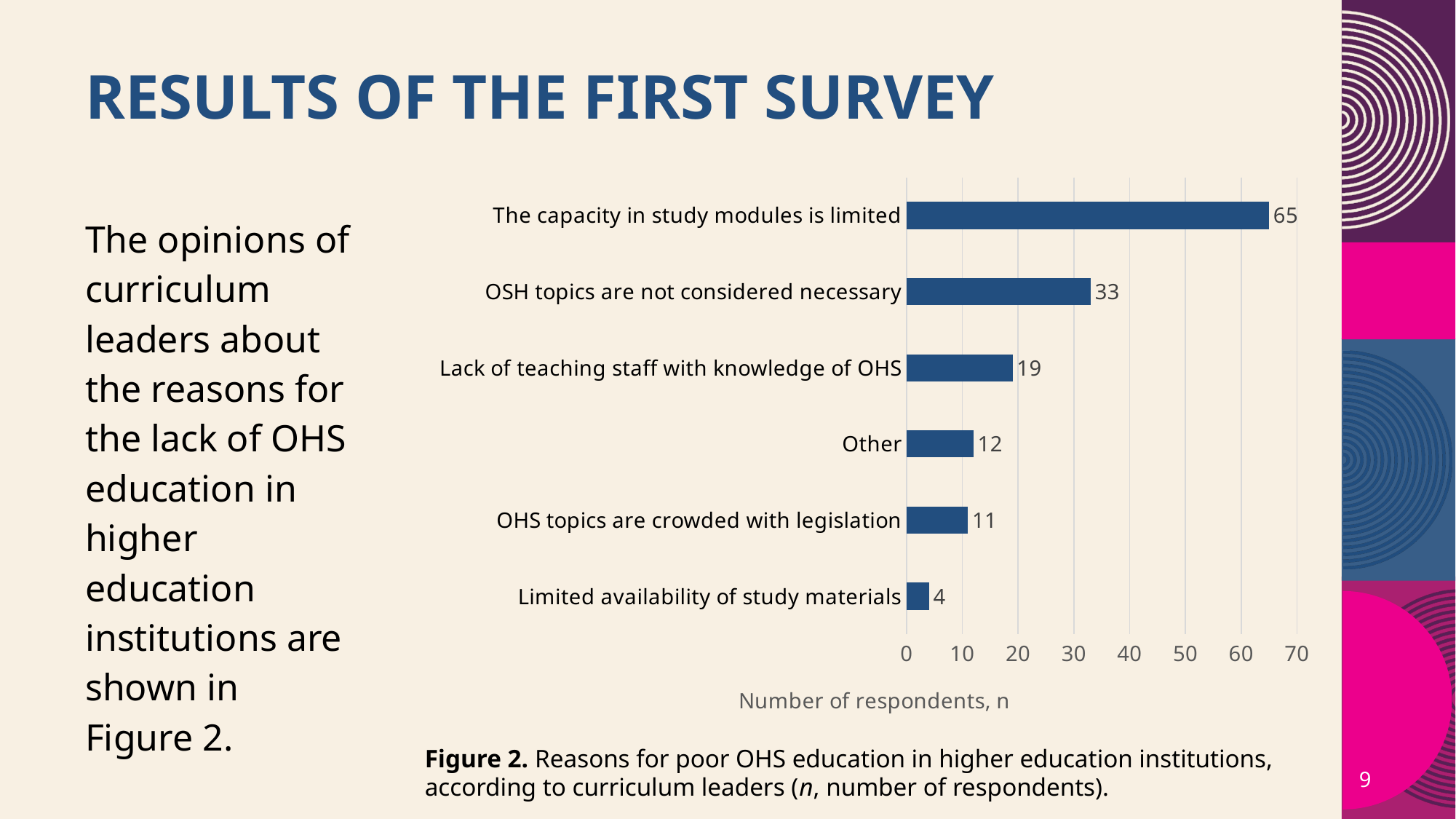
Which has more respondents: 'Other' or 'OHS topics are crowded with legislation'? Other Which reason has the lowest number of respondents? Limited availability of study materials What is the value for 'OSH topics are not considered necessary'? 33 Is the value for 'Lack of teaching staff with knowledge of OHS' greater or less than 20? less Which reason has the highest number of respondents? The capacity in study modules is limited What is the difference between the values for 'The capacity in study modules is limited' and 'OSH topics are not considered necessary'? 32 How many respondents cited 'The capacity in study modules is limited' as a reason? 65 What is the label of the horizontal axis of the chart? Number of respondents, n What type of chart is shown on the slide? Bar chart How many respondents selected 'Lack of teaching staff with knowledge of OHS'? 19 What is the value for 'Limited availability of study materials'? 4 How many reasons (categories) are shown in the chart? 6